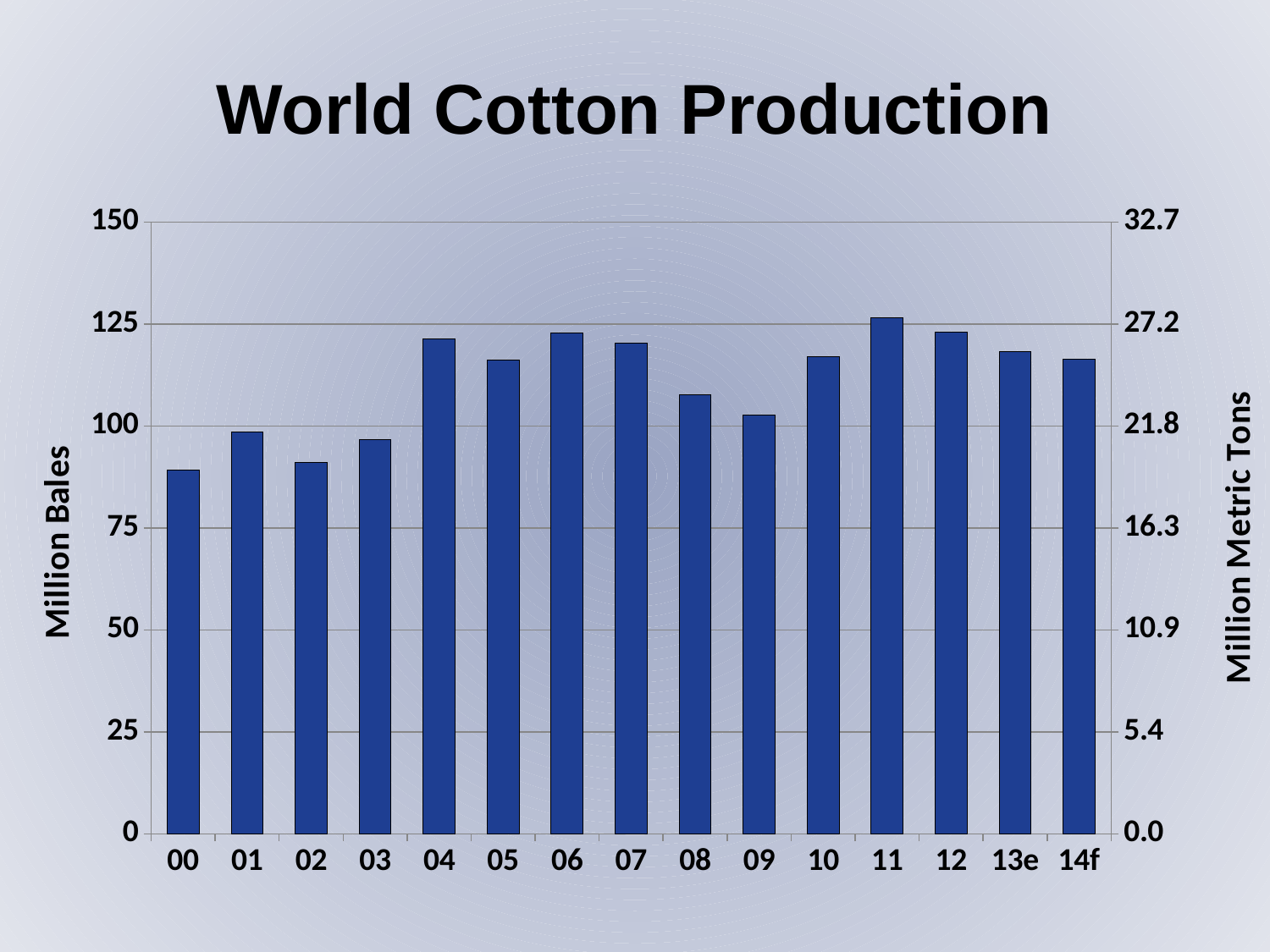
Which is larger, the value for 11 or the value for 12? 11 Do the values rise or fall from 06 to 09? fall Which year has the highest world cotton production? 11 What is the label of the left vertical axis? Million Bales Is the value for 00 greater or less than 100 million bales? less Which is larger, the value for 08 or the value for 09? 08 What kind of chart is shown on the slide? bar chart How many years (bars) are shown on the x axis? 15 Is the value for 02 greater or less than 100 million bales? less Is the value for 04 greater or less than 100 million bales? greater What is the title of the chart? World Cotton Production